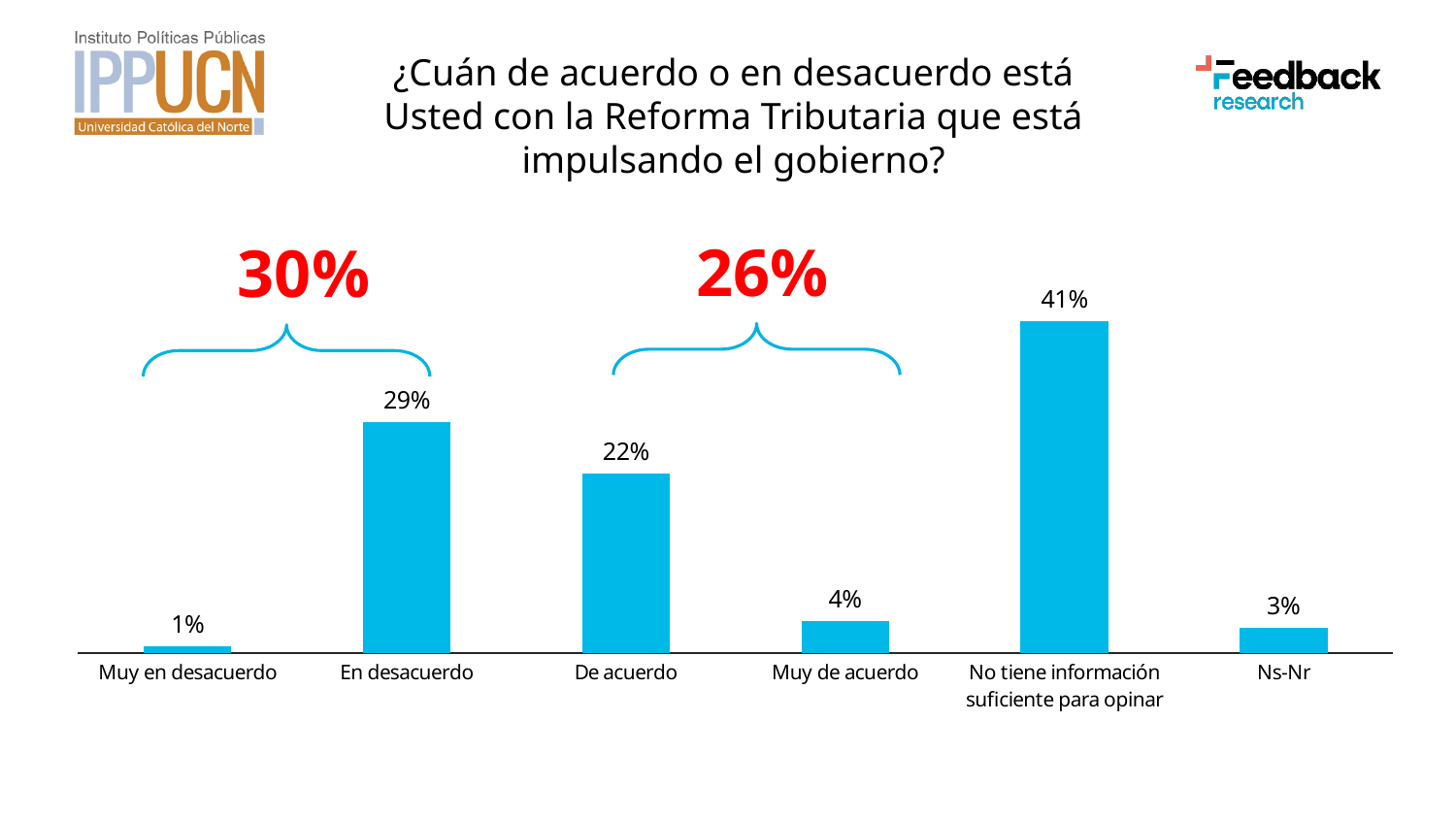
What is the value for "De acuerdo"? 22% What is the value for "Muy de acuerdo"? 4% What is the value for "Ns-Nr"? 3% Which is larger, the value for "Muy de acuerdo" or the value for "Ns-Nr"? Muy de acuerdo Which category has the highest value? No tiene información suficiente para opinar What kind of chart is shown on the slide? Bar chart What is the value for "No tiene información suficiente para opinar"? 41% What is the value for "En desacuerdo"? 29% What combined percentage is shown in red above the bracket grouping "De acuerdo" and "Muy de acuerdo"? 26% Which category has the lowest value? Muy en desacuerdo How many categories are shown on the chart? 6 What is the difference between the values for "En desacuerdo" and "De acuerdo"? 7%